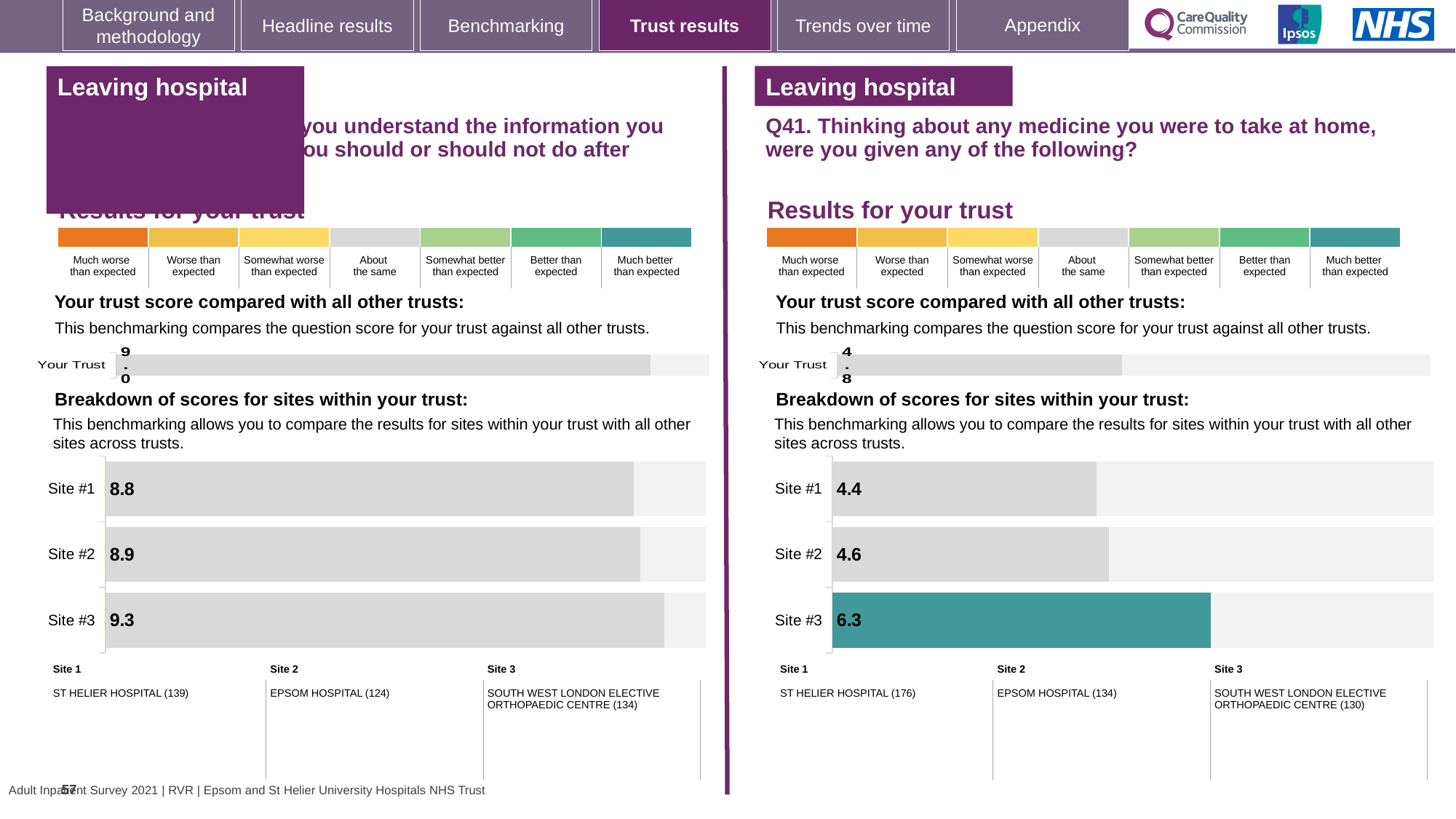
What type of chart is used for the breakdown of scores for sites on the right-hand side (Q41)? Bar chart On the left-hand chart, which is larger: the score for Site #1 or Site #3? Site #3 On the right-hand chart (Q41), what is the score for Site #1? 4.4 How many sites are shown in the site breakdown chart on the right-hand side (Q41)? 3 On the left-hand chart, which site has the highest score? Site #3 On the left-hand chart, what is the 'Your Trust' score? 9.0 On the left-hand chart, what is the score for Site #2? 8.9 On the right-hand chart (Q41), what is the score for Site #3? 6.3 On the right-hand chart (Q41), what is the 'Your Trust' score? 4.8 On the left-hand chart, what is the difference between the scores for Site #3 and Site #1? 0.5 On the right-hand chart (Q41), which site has the lowest score? Site #1 On the right-hand chart (Q41), what is the difference between the scores for Site #3 and Site #2? 1.7